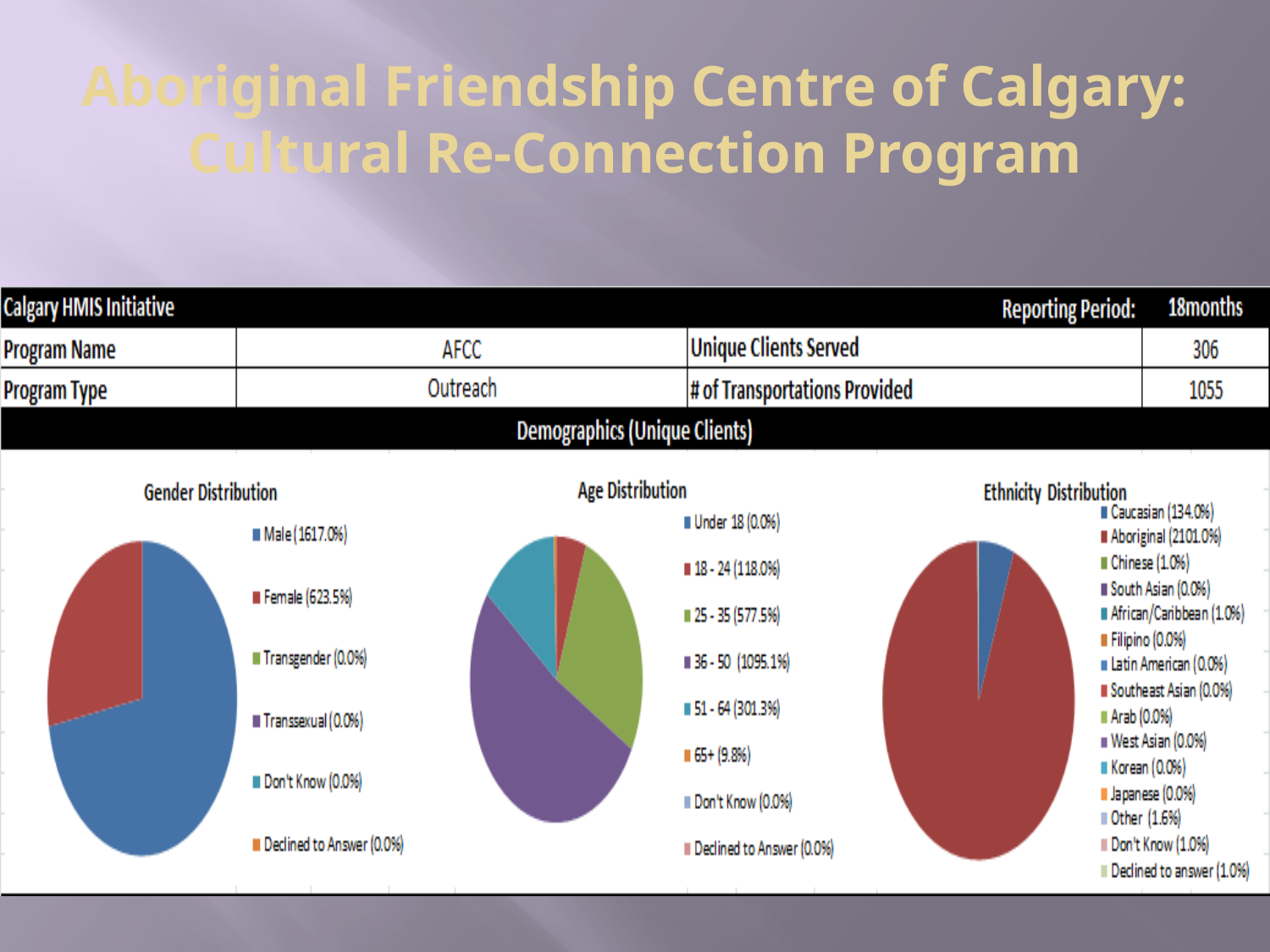
In the Age Distribution chart, what value is shown for 51 - 64 in the legend? 301.3% In the Age Distribution chart, which age group has the largest slice? 36 - 50 In the Age Distribution chart, what value is shown for 25 - 35 in the legend? 577.5% How many categories does the legend of the Gender Distribution chart list? 6 How many categories does the legend of the Age Distribution chart list? 8 In the Ethnicity Distribution chart, what value is shown for Caucasian in the legend? 134.0% In the Age Distribution chart, which is larger, the value for 18 - 24 or the value for 65+? 18 - 24 In the Gender Distribution chart, what value is shown for Male in the legend? 1617.0% In the Ethnicity Distribution chart, which category has the largest slice? Aboriginal In the Gender Distribution chart, what is the difference between the Male and Female values shown in the legend? 993.5% What kind of chart is the Gender Distribution chart? pie chart In the Gender Distribution chart, what value is shown for Female in the legend? 623.5%